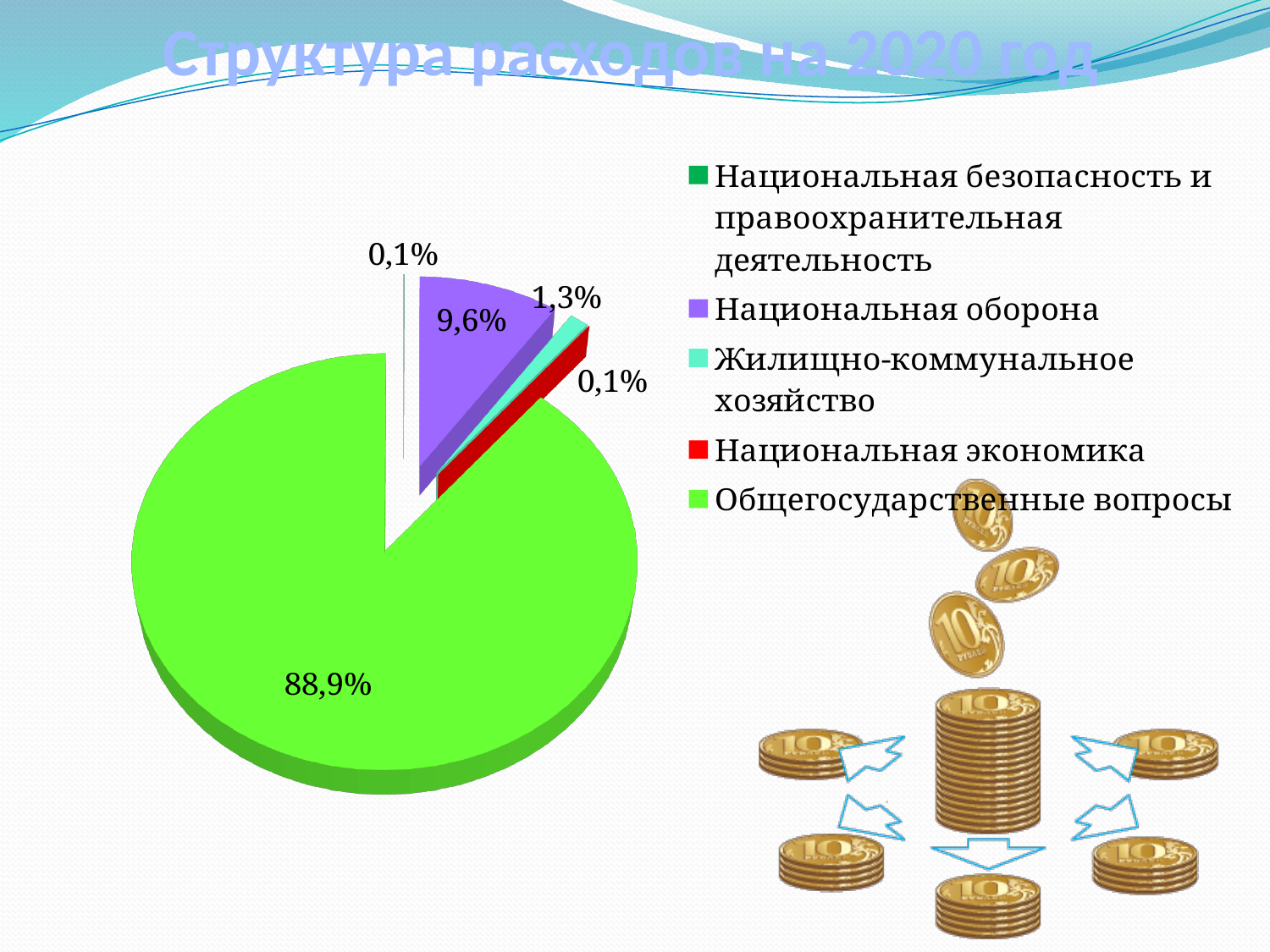
How many categories does the legend list? 5 What share of expenditures is labelled for Жилищно-коммунальное хозяйство? 1,3% What is the difference between the shares of Общегосударственные вопросы and Национальная оборона? 79,3% What share of expenditures is labelled for Национальная оборона? 9,6% Which is larger, the share for Национальная оборона or the share for Жилищно-коммунальное хозяйство? Национальная оборона What is the difference between the shares of Национальная оборона and Жилищно-коммунальное хозяйство? 8,3% What colour is the slice for Национальная экономика? red Which category has the largest slice of the pie? Общегосударственные вопросы What kind of chart is shown on the slide? pie chart What share of expenditures is labelled for Национальная экономика? 0,1% What is the title of the chart? Структура расходов на 2020 год What share of expenditures is labelled for Общегосударственные вопросы? 88,9%